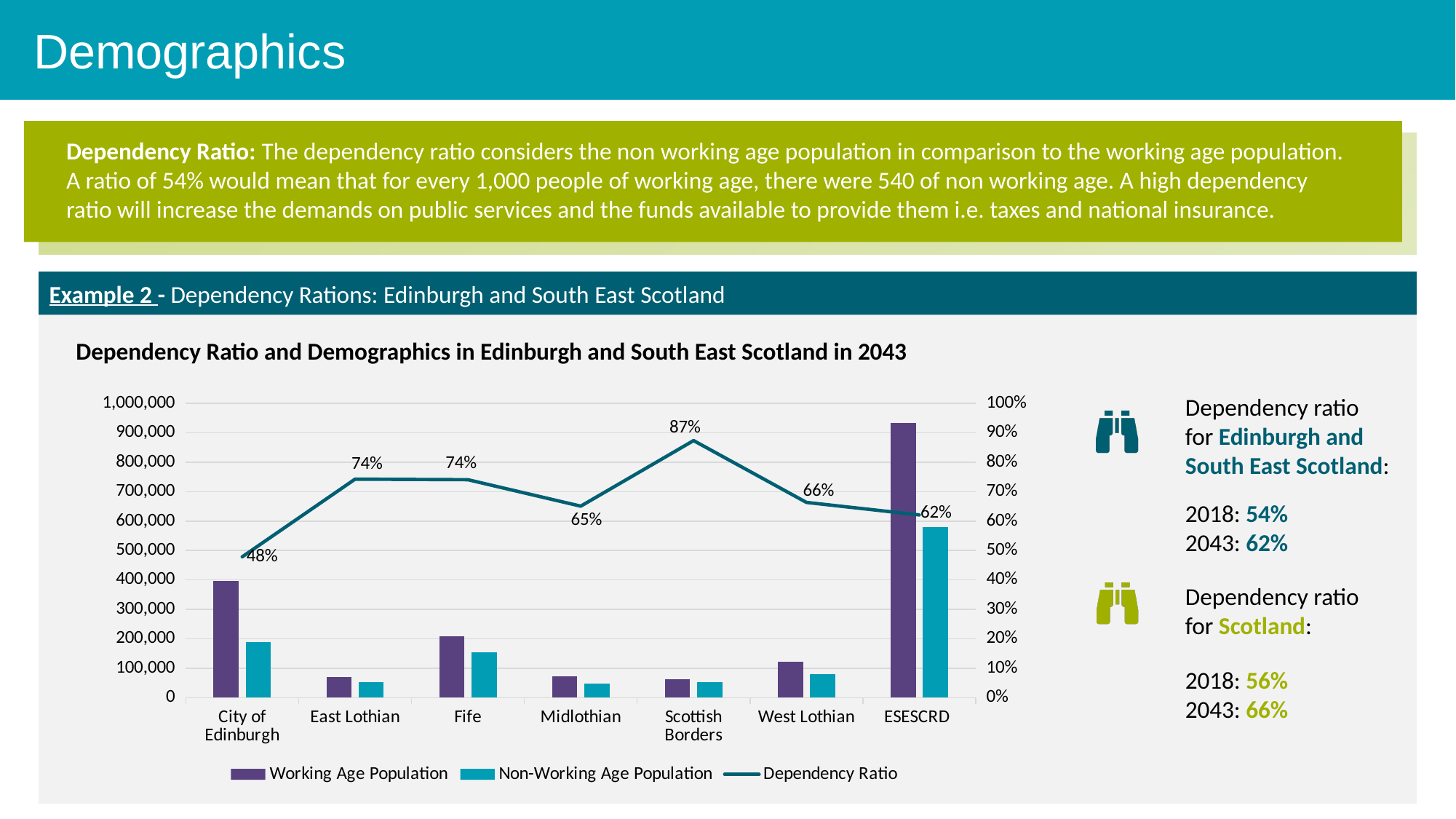
Is the Non-Working Age Population for City of Edinburgh greater or less than 100,000? greater How many areas are shown on the x axis of the chart? 7 Which area has the lowest Dependency Ratio? City of Edinburgh Which area has the highest Dependency Ratio? Scottish Borders Is the Working Age Population for ESESCRD greater or less than 900,000? greater Which has the larger Working Age Population, City of Edinburgh or Fife? City of Edinburgh What kind of chart is shown on the slide? Bar chart with a line What is the Dependency Ratio for Scottish Borders? 87% How many series does the chart legend list? 3 What is the Dependency Ratio for ESESCRD? 62% Which has the higher Dependency Ratio, Midlothian or West Lothian? West Lothian What is the difference between the Dependency Ratio for Scottish Borders and for City of Edinburgh? 39 percentage points